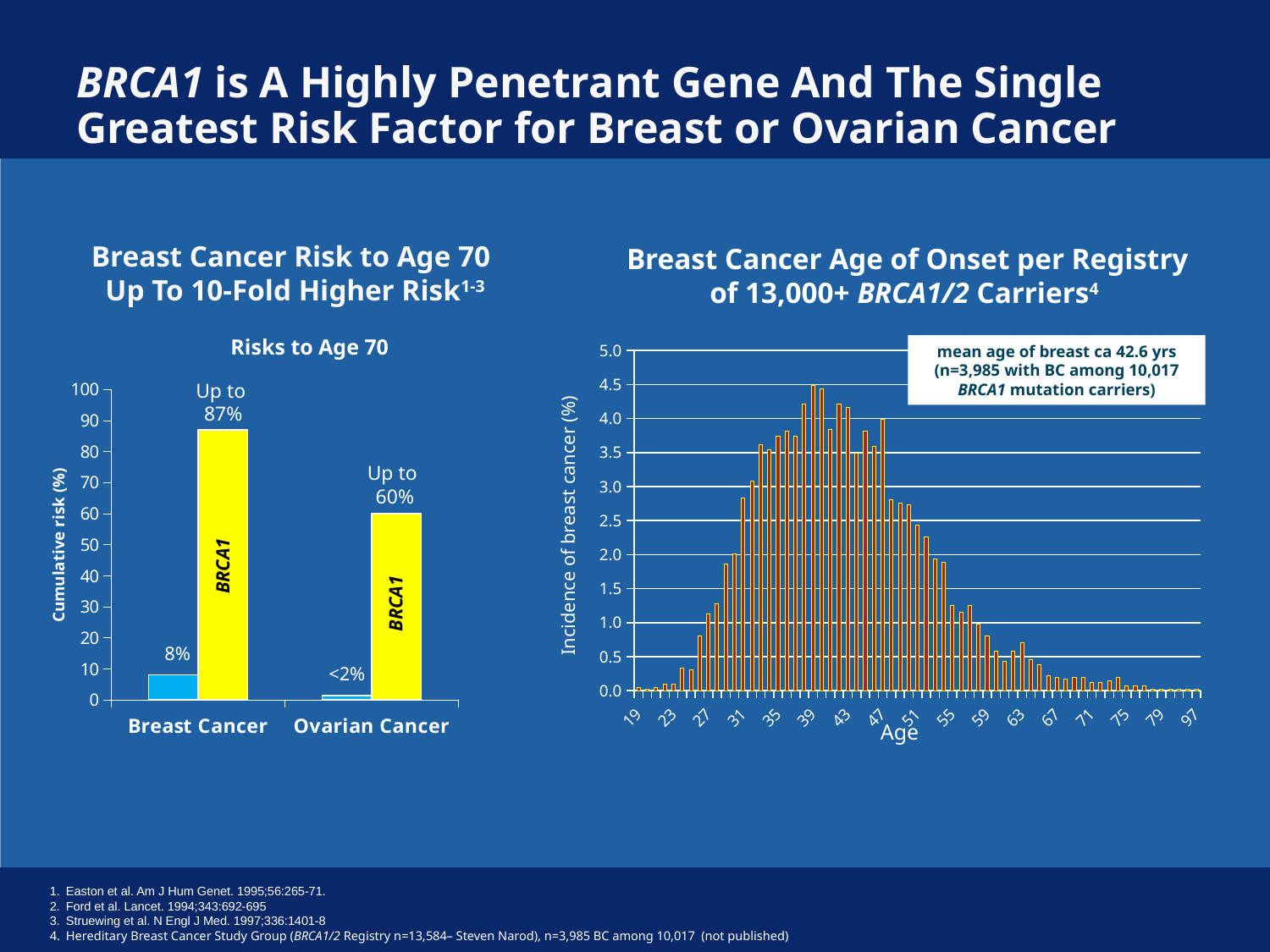
In the 'Risks to Age 70' chart on the left, what is the cumulative risk of ovarian cancer shown for BRCA1 carriers? Up to 60% What kind of chart is the 'Breast Cancer Age of Onset' chart on the right? Bar chart In the 'Breast Cancer Age of Onset' chart on the right, do the values rise or fall along the x axis from age 47 to age 67? fall In the 'Breast Cancer Age of Onset' chart on the right, what is the label of the y axis? Incidence of breast cancer (%) In the 'Risks to Age 70' chart on the left, what is the value of the blue (non-BRCA1) bar for Breast Cancer? 8% In the 'Risks to Age 70' chart on the left, which BRCA1 bar is taller, Breast Cancer or Ovarian Cancer? Breast Cancer In the 'Risks to Age 70' chart on the left, what is the value of the non-BRCA1 bar for Ovarian Cancer? <2% In the 'Risks to Age 70' chart on the left, what is the cumulative risk of breast cancer shown for BRCA1 carriers? Up to 87% In the 'Breast Cancer Age of Onset' chart on the right, is the incidence at age 39 greater or less than 4.0? greater In the 'Risks to Age 70' chart on the left, what is the label of the y axis? Cumulative risk (%) What kind of chart is the 'Risks to Age 70' chart on the left? Bar chart In the 'Risks to Age 70' chart on the left, how many cancer categories are shown on the x axis? 2